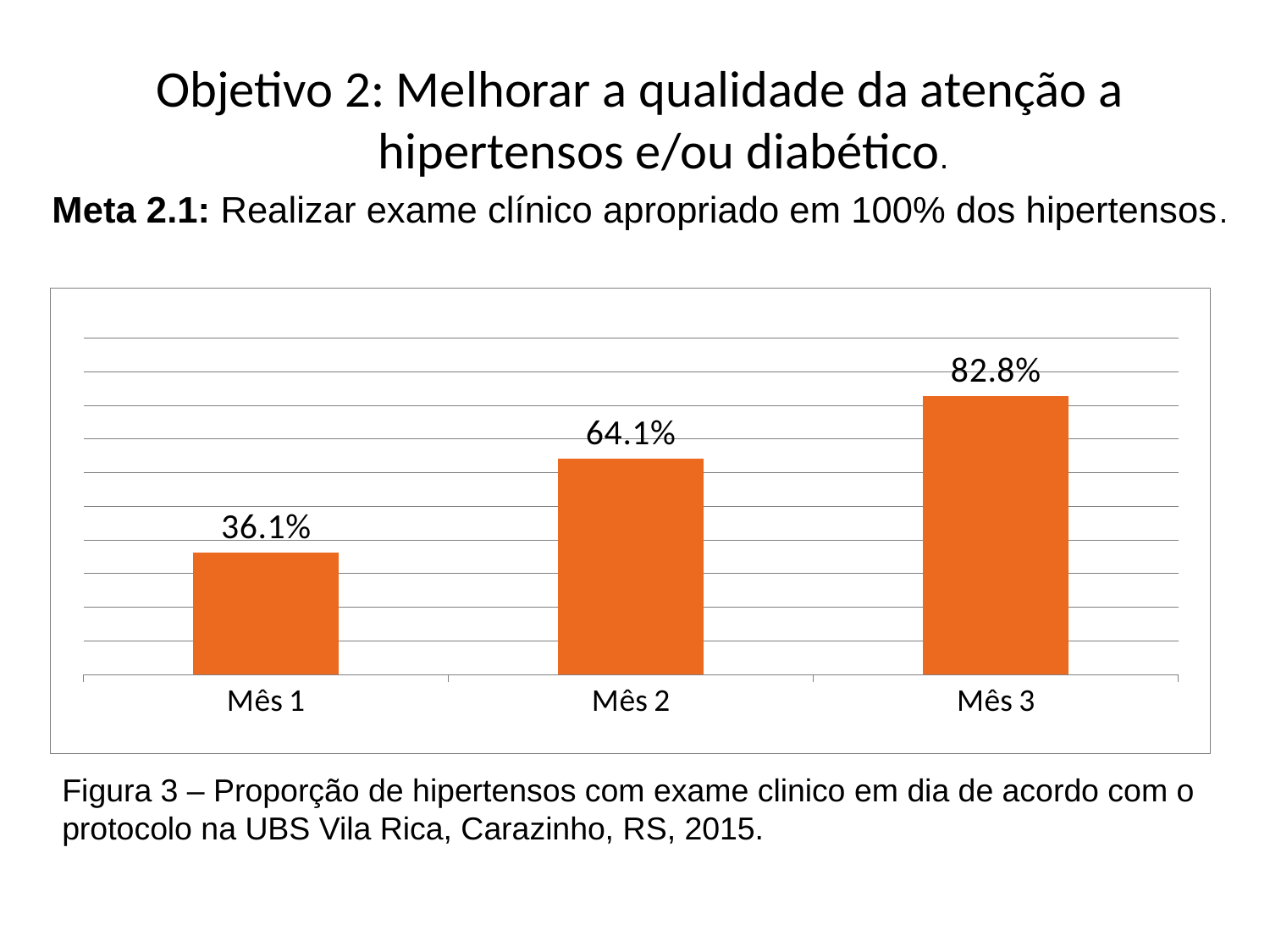
How many months are shown on the chart? 3 What kind of chart is shown on the slide? Bar chart What is the value for Mês 3? 82.8% What is the difference between the values for Mês 2 and Mês 1? 28.0% Which month has the highest value? Mês 3 Which month has the lowest value? Mês 1 Do the values rise or fall from Mês 1 to Mês 3? Rise What is the value for Mês 1? 36.1% What is the value for Mês 2? 64.1% What is the difference between the values for Mês 3 and Mês 1? 46.7% What colour are the bars in the chart? Orange Which is larger, the value for Mês 2 or the value for Mês 3? Mês 3